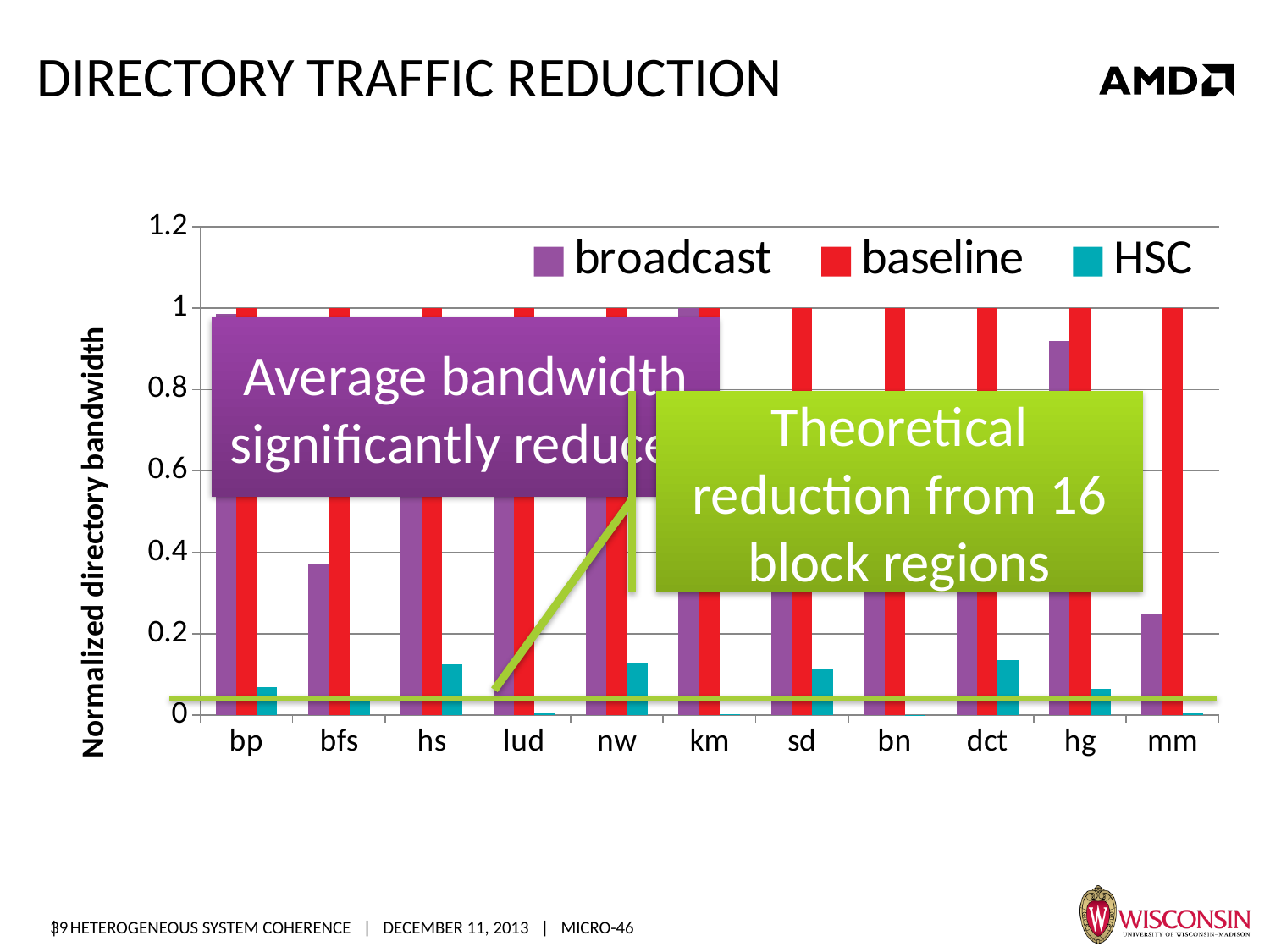
Is the broadcast value for mm greater or less than 0.4? less How many categories are shown along the x axis? 11 Is the broadcast value for hg greater or less than 0.8? greater For bp, which is larger: the broadcast value or the HSC value? broadcast What is the baseline value for mm? 1 What is the title of the y axis? Normalized directory bandwidth Is the broadcast value for bfs greater or less than 0.6? less Which colour represents the HSC series in the legend? teal For mm, which is larger: the baseline value or the broadcast value? baseline What kind of chart is shown on the slide? bar chart How many series does the legend list? 3